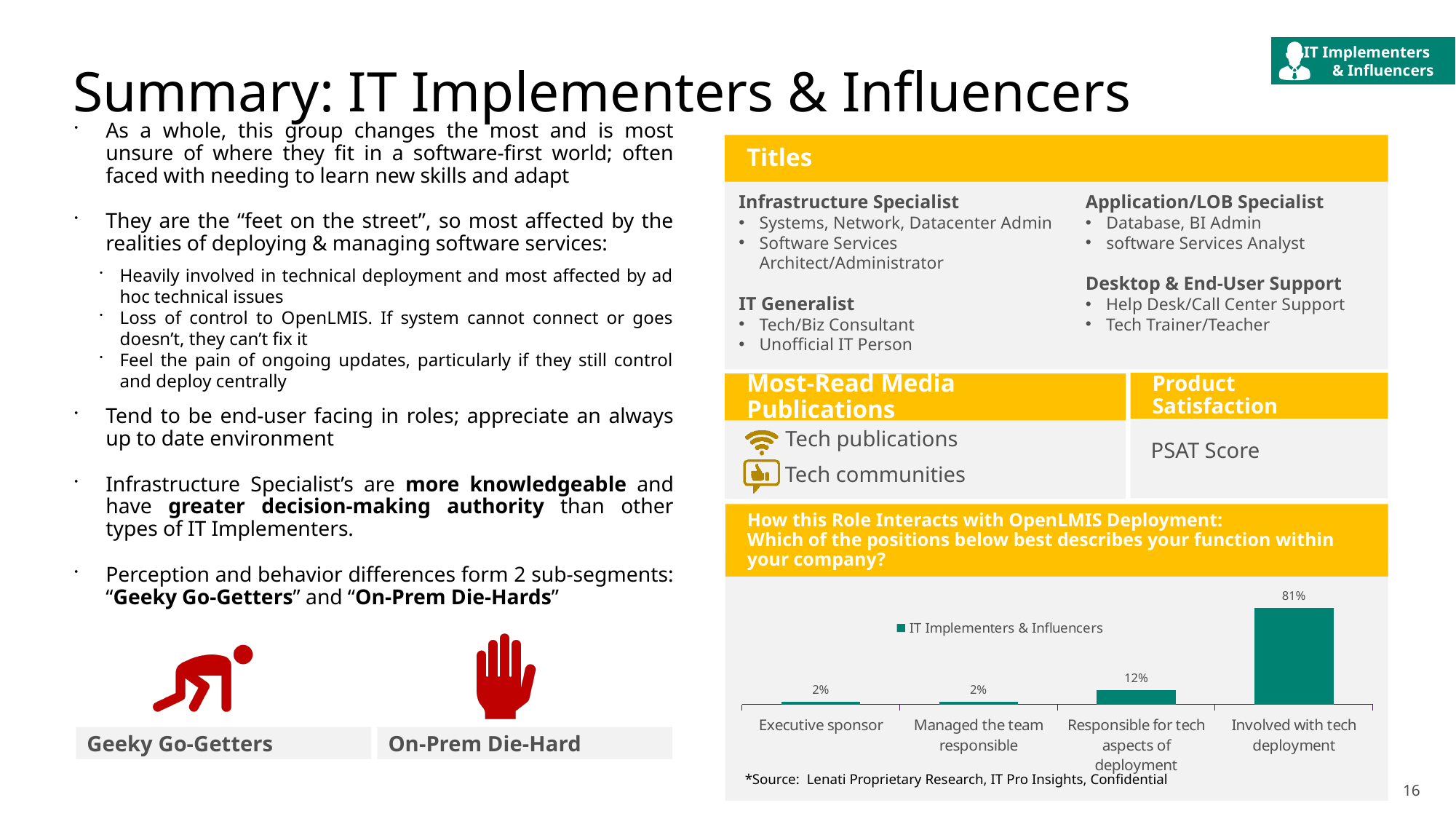
What percentage is shown for 'Involved with tech deployment'? 81% How many categories are shown in the chart? 4 What percentage is shown for 'Executive sponsor'? 2% What percentage is shown for 'Responsible for tech aspects of deployment'? 12% What is the difference between 'Responsible for tech aspects of deployment' and 'Executive sponsor'? 10% How many series does the chart legend list? 1 What percentage is shown for 'Managed the team responsible'? 2% What series name is shown in the chart legend? IT Implementers & Influencers What is the difference between 'Involved with tech deployment' and 'Responsible for tech aspects of deployment'? 69% Which is larger: 'Responsible for tech aspects of deployment' or 'Managed the team responsible'? Responsible for tech aspects of deployment Which category has the highest value in the chart? Involved with tech deployment What kind of chart is shown on the slide? Bar chart